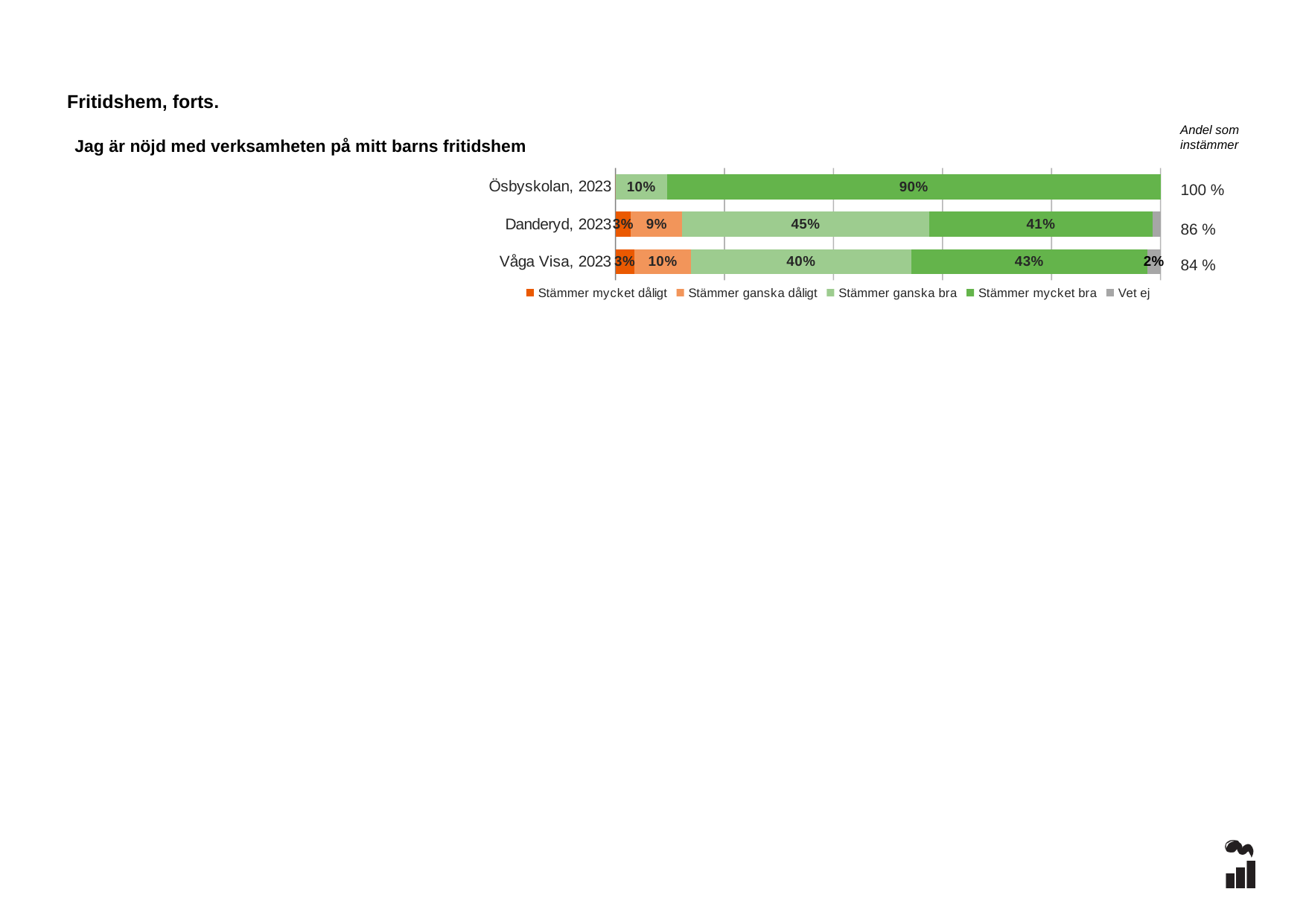
Which is larger: "Stämmer ganska bra" for Danderyd, 2023 or for Våga Visa, 2023? Danderyd, 2023 What is the difference between the "Stämmer mycket bra" values for Ösbyskolan, 2023 and Våga Visa, 2023? 47 percentage points How many categories (bars) does the chart show? 3 What is the value of "Stämmer ganska bra" for Danderyd, 2023? 45% How many series does the legend list? 5 What is the value of "Stämmer ganska dåligt" for Våga Visa, 2023? 10% What is the "Andel som instämmer" value shown for Danderyd, 2023? 86 % What kind of chart is shown on the slide? Stacked bar chart Which category has the lowest value for "Stämmer mycket bra"? Danderyd, 2023 What is the value of "Stämmer mycket bra" for Ösbyskolan, 2023? 90% Which category has the highest value for "Stämmer mycket bra"? Ösbyskolan, 2023 What is the value of "Vet ej" for Våga Visa, 2023? 2%